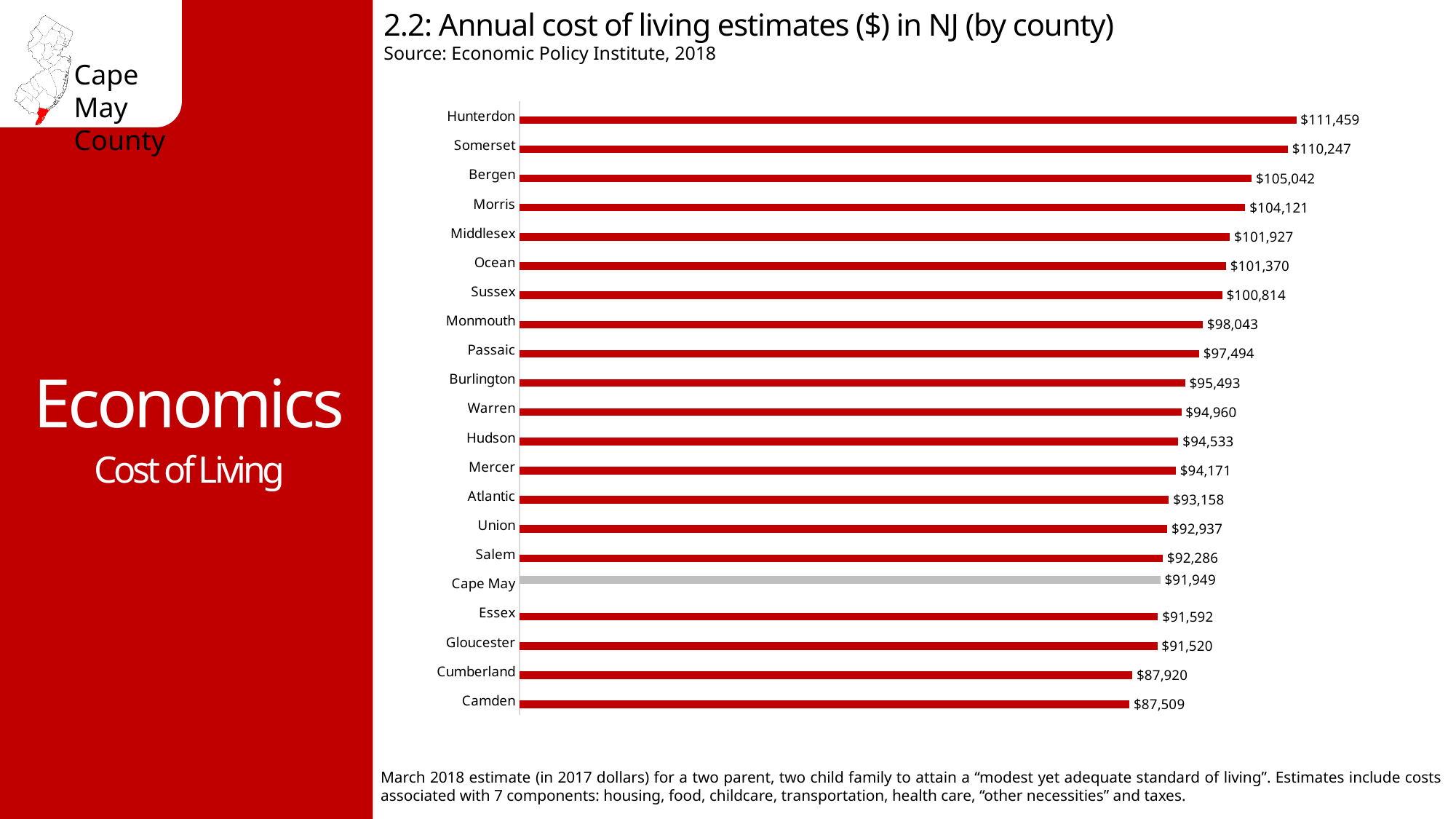
Which county has a higher cost of living estimate, Bergen or Atlantic? Bergen What is the annual cost of living estimate for Monmouth county? $98,043 What is the annual cost of living estimate for Hunterdon county? $111,459 What is the annual cost of living estimate for Cape May county? $91,949 Which county has the highest annual cost of living estimate? Hunterdon What is the difference between the cost of living estimates for Cape May and Camden? $4,440 What type of chart is used to show the annual cost of living estimates? Bar chart How many counties are shown in the chart? 21 Which county has the lowest annual cost of living estimate? Camden What is the difference between the cost of living estimates for Hunterdon and Camden? $23,950 Which county's bar is shown in grey rather than red? Cape May Which county has a higher cost of living estimate, Cumberland or Passaic? Passaic